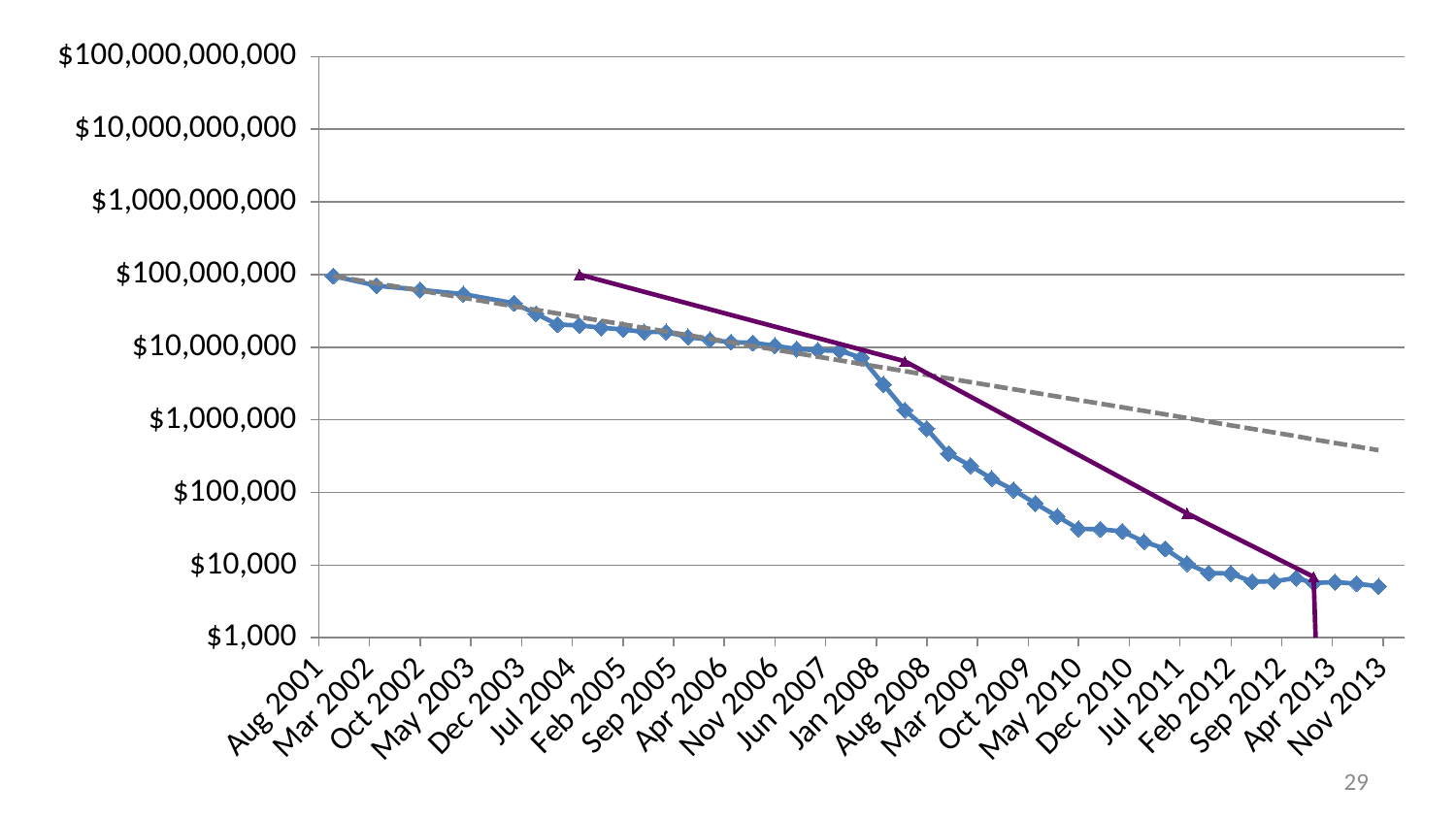
Does the blue diamond line rise or fall from Aug 2001 to Nov 2013? fall At Nov 2013, which line is higher: the grey dashed line or the blue diamond line? grey dashed line Is the value of the blue diamond line at Aug 2001 greater or less than $10,000,000? greater Is the value of the grey dashed line at Nov 2013 greater or less than $100,000? greater Is the value of the purple triangle line at Jul 2011 greater or less than $100,000? less At Jul 2011, which line is higher: the purple triangle line or the blue diamond line? purple triangle line How many lines are plotted on the chart? 3 What is the highest value labelled on the vertical axis? $100,000,000,000 What is the lowest value labelled on the vertical axis? $1,000 What kind of chart is shown on the slide? line chart